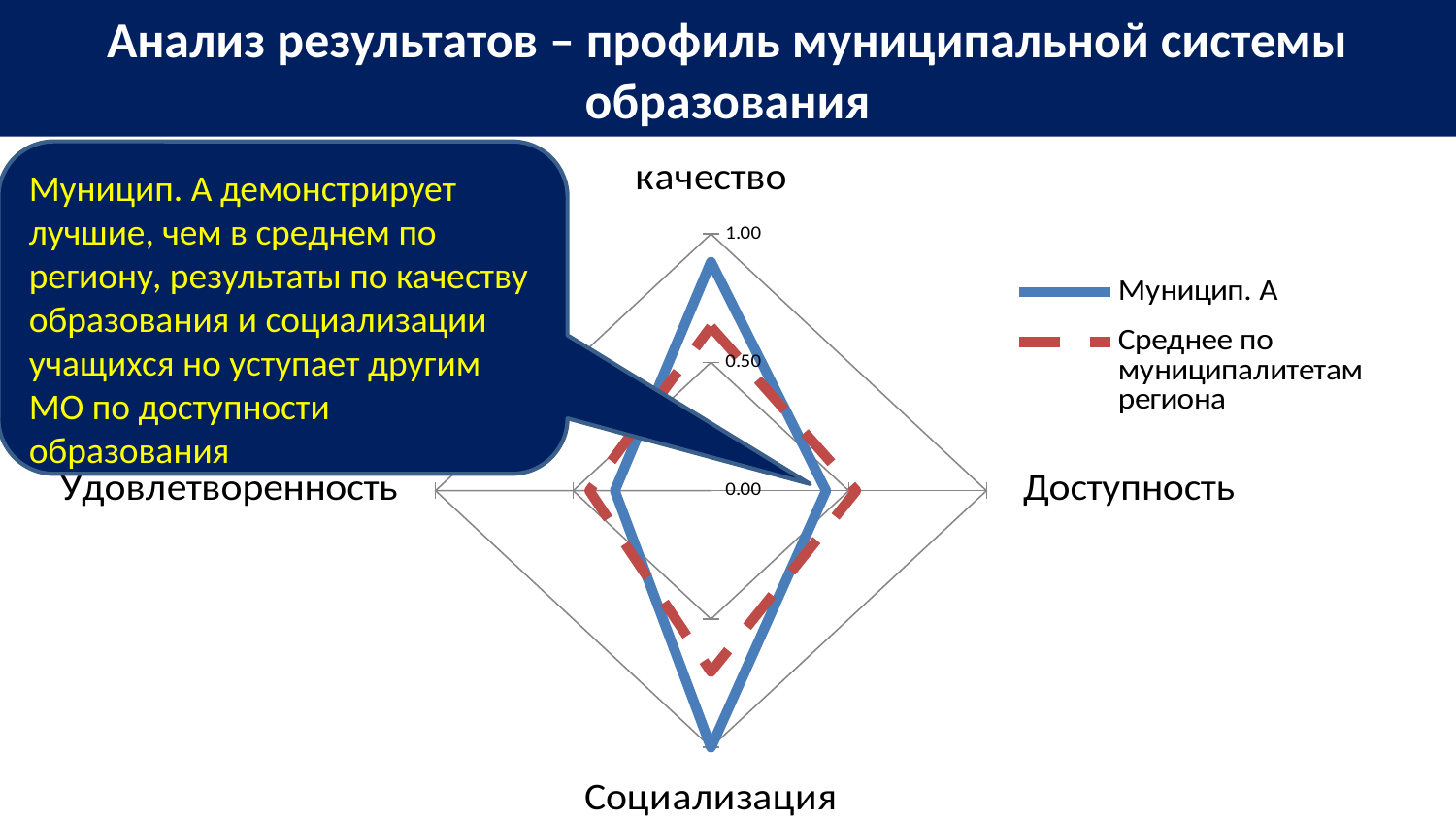
For Социализация, which series has the larger value: Муницип. А or Среднее по муниципалитетам региона? Муницип. А Is the value of Муницип. А for качество greater or less than 0.50? greater Is the value of Муницип. А for Доступность greater or less than 0.50? less Which series is drawn with a dashed red line? Среднее по муниципалитетам региона For Доступность, which series has the larger value: Муницип. А or Среднее по муниципалитетам региона? Среднее по муниципалитетам региона For качество, which series has the larger value: Муницип. А or Среднее по муниципалитетам региона? Муницип. А Is the value of Муницип. А for Удовлетворенность greater or less than 0.50? less How many series does the legend list? 2 What kind of chart is shown on the slide? Radar chart Which series is drawn with a solid blue line? Муницип. А How many categories (axes) does the radar chart have? 4